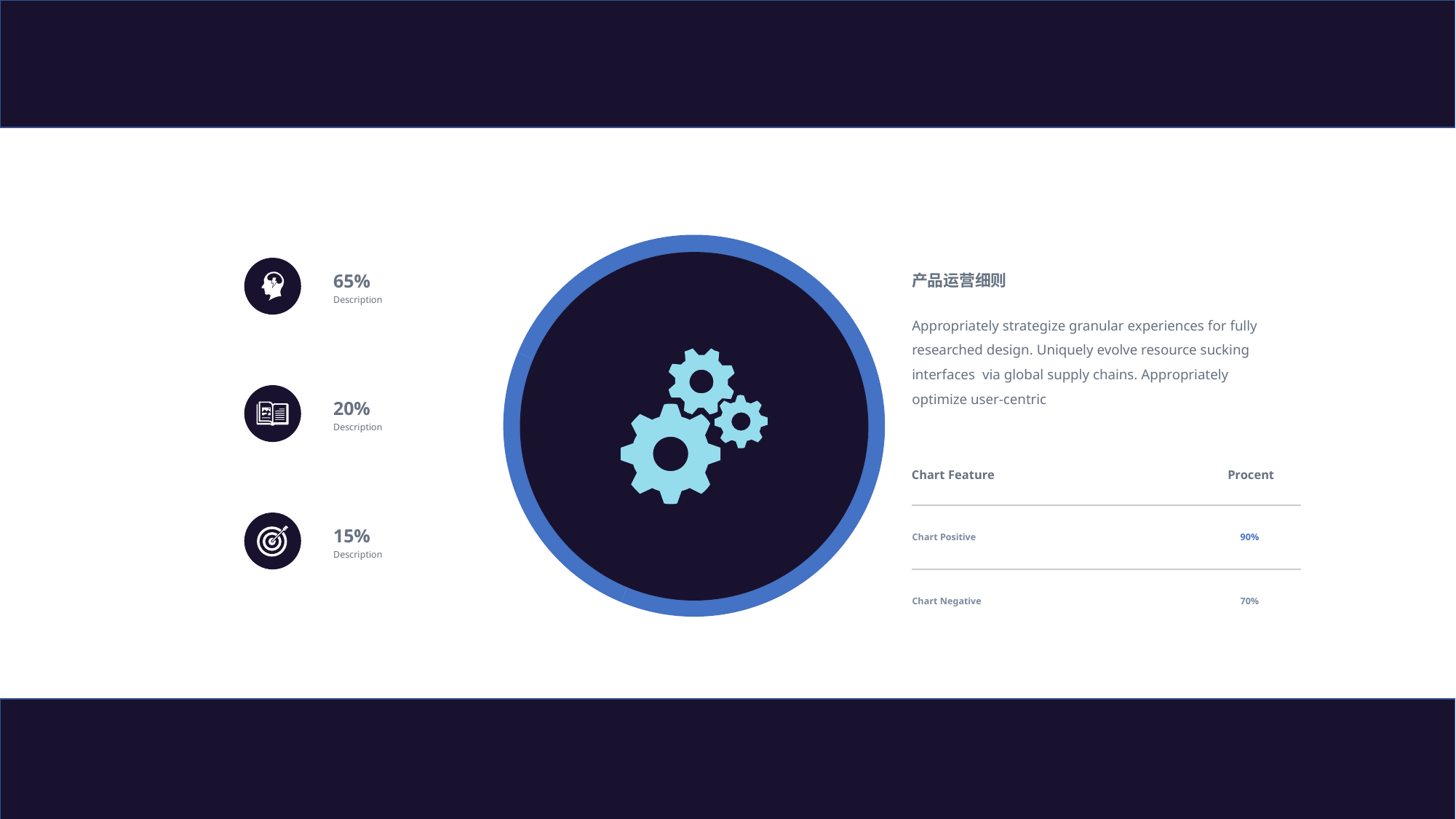
What percentage is shown next to the book icon on the left? 20% In the table on the right, which has the larger percentage, Chart Positive or Chart Negative? Chart Positive What kind of chart surrounds the gear icon in the centre of the slide? pie chart What are the two column headings of the table on the right? Chart Feature and Procent In the table on the right, what percentage is listed for Chart Positive? 90% In the table on the right, what percentage is listed for Chart Negative? 70% How many rows of data are listed in the Chart Feature table? 2 Which of the three percentages on the left side of the slide is the lowest? 15% Which of the three percentages on the left side of the slide is the highest? 65% What percentage is shown next to the target icon on the left? 15% In the table on the right, what is the difference between the Chart Positive and Chart Negative percentages? 20% What percentage is shown next to the brain icon on the left? 65%